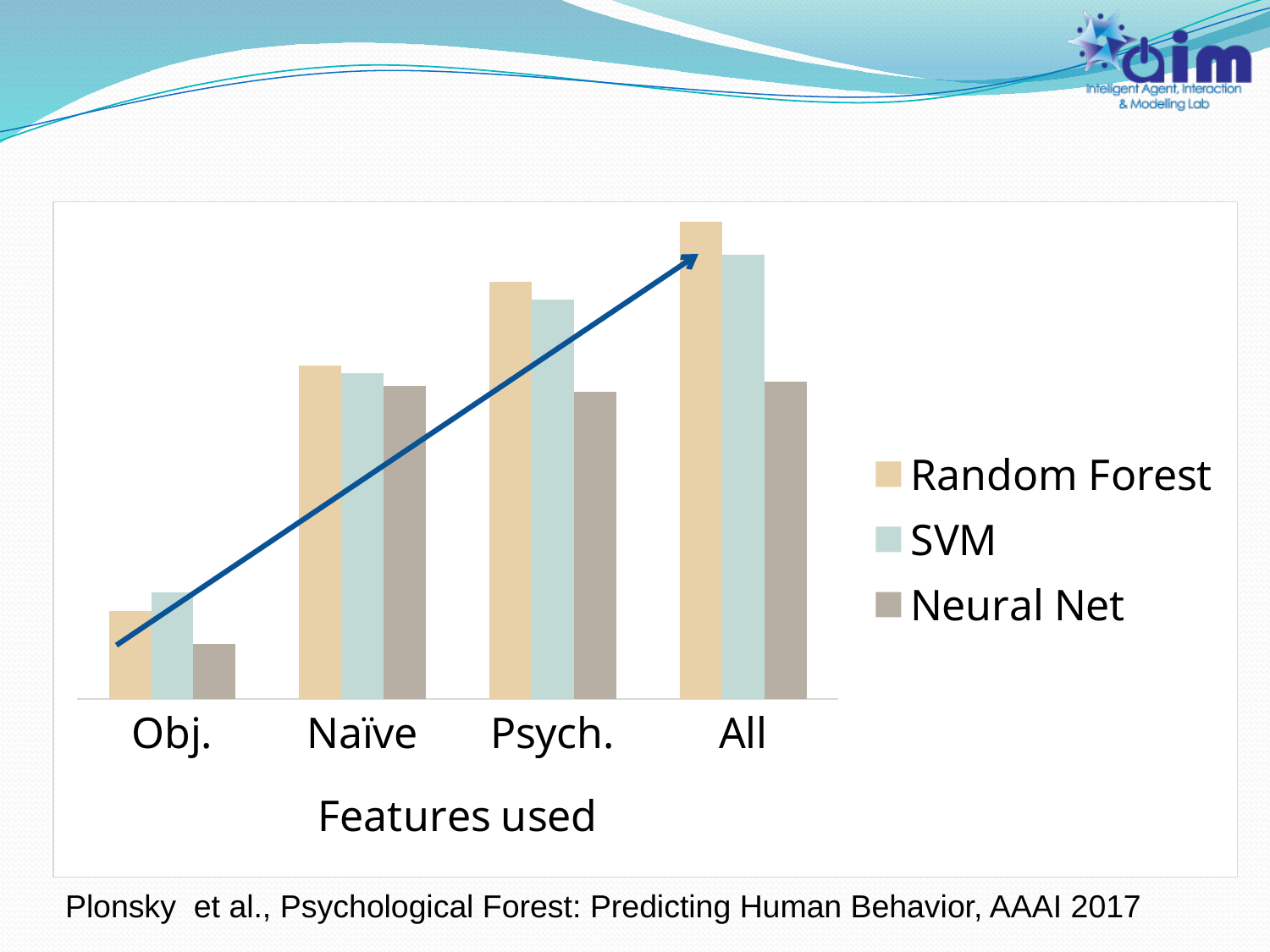
For which feature set is the Random Forest bar the shortest? Obj. How many series does the chart's legend list? 3 Which series are listed in the chart's legend? Random Forest, SVM, Neural Net For which feature set is the Random Forest bar the tallest? All Is the Random Forest bar taller for All or for Psych.? All For which feature set is the SVM bar the tallest? All Within the Obj. category, which series has the lowest bar? Neural Net How many categories are shown along the x axis of the chart? 4 For which feature set is the Neural Net bar the shortest? Obj. What kind of chart is shown on the slide? Bar chart Do the Random Forest values rise or fall moving from Obj. to All along the x axis? Rise What is the title of the x axis of the chart? Features used